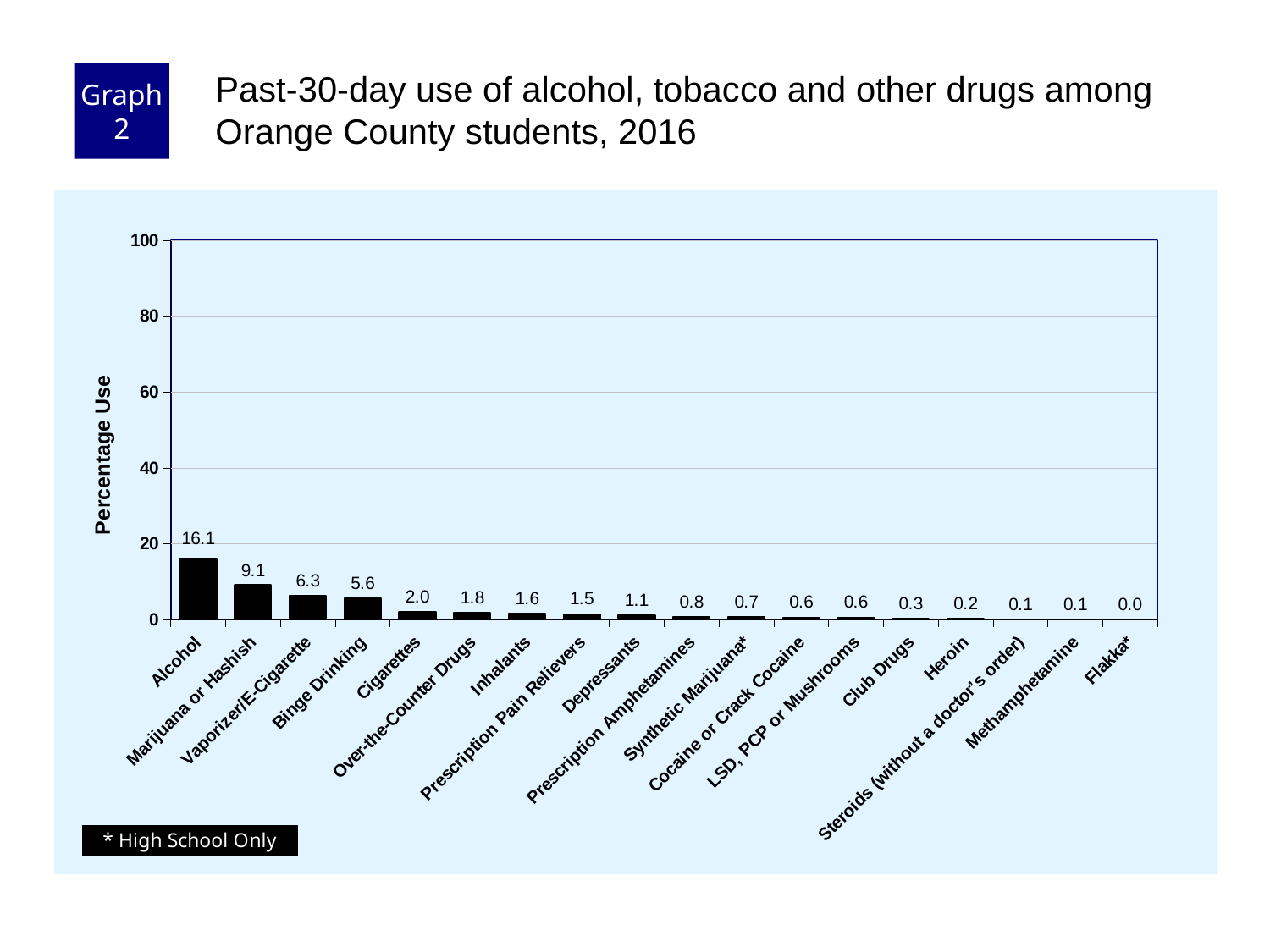
What is the label of the y axis? Percentage Use Which category has the lowest percentage use? Flakka* What kind of chart is shown on the slide? Bar chart What is the percentage use for Vaporizer/E-Cigarette? 6.3 What is the difference in percentage use between Alcohol and Marijuana or Hashish? 7.0 What is the percentage use for Heroin? 0.2 Is the value for Marijuana or Hashish greater or less than 20? less What is the percentage use for Cigarettes? 2.0 Which category has the highest percentage use? Alcohol What is the percentage use for Alcohol? 16.1 Which has a higher percentage use, Binge Drinking or Inhalants? Binge Drinking How many categories are shown on the x axis? 18